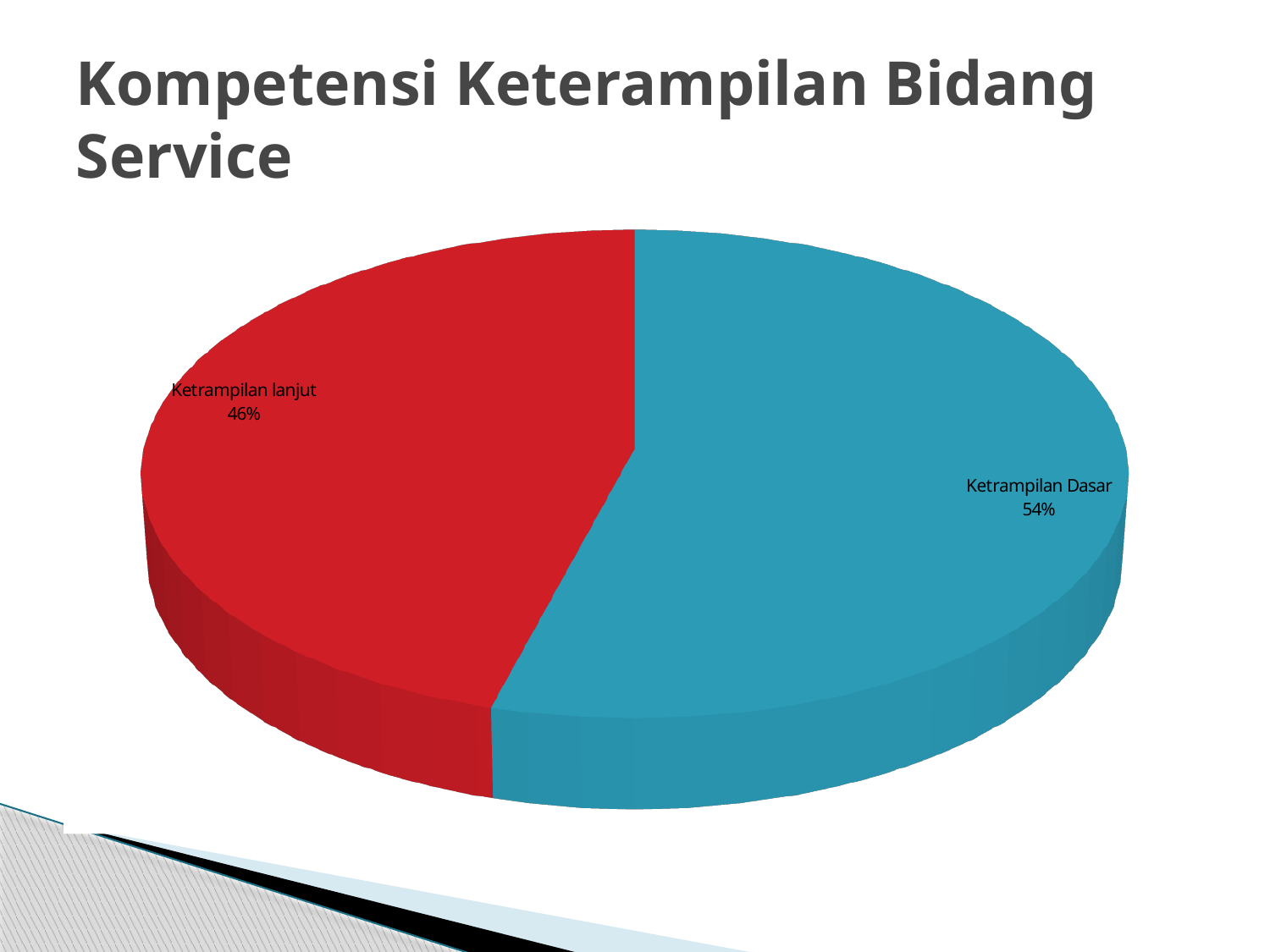
What is the difference in percentage points between Ketrampilan Dasar and Ketrampilan lanjut? 8 Which slice is the smallest? Ketrampilan lanjut What share of the pie does Ketrampilan Dasar have? 54% What share of the pie does Ketrampilan lanjut have? 46% What kind of chart is shown on the slide? pie chart What is the title of the slide containing the pie chart? Kompetensi Keterampilan Bidang Service What colour is the Ketrampilan lanjut slice? red Is the share for Ketrampilan Dasar greater or less than 50%? greater Which is larger, Ketrampilan Dasar or Ketrampilan lanjut? Ketrampilan Dasar Which slice is the largest? Ketrampilan Dasar How many slices does the pie chart have? 2